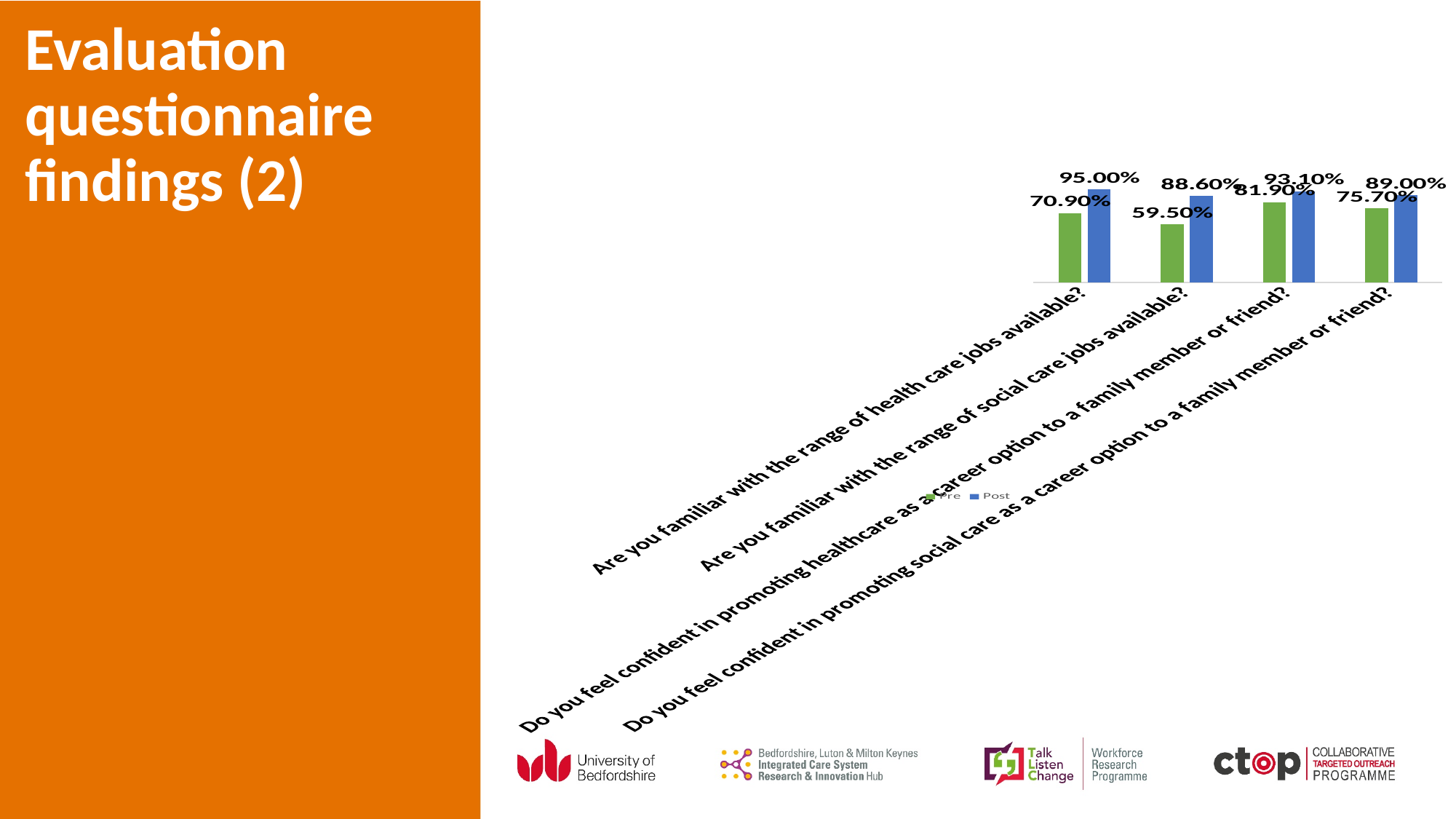
What is the Pre value for "Are you familiar with the range of social care jobs available?"? 59.50% What type of chart is shown on the slide? Bar chart Which is larger for "Do you feel confident in promoting social care as a career option to a family member or friend?": the Pre value or the Post value? Post How many series does the legend list? 2 Which question has the highest Post value? Are you familiar with the range of health care jobs available? What is the Pre value for "Do you feel confident in promoting social care as a career option to a family member or friend?"? 75.70% What is the Pre value for "Are you familiar with the range of health care jobs available?"? 70.90% What is the Post value for "Do you feel confident in promoting healthcare as a career option to a family member or friend?"? 93.10% What is the difference between the Post and Pre values for "Are you familiar with the range of social care jobs available?"? 29.10% How many questions (categories) are shown on the chart? 4 Which question has the lowest Pre value? Are you familiar with the range of social care jobs available? What is the Post value for "Are you familiar with the range of health care jobs available?"? 95.00%